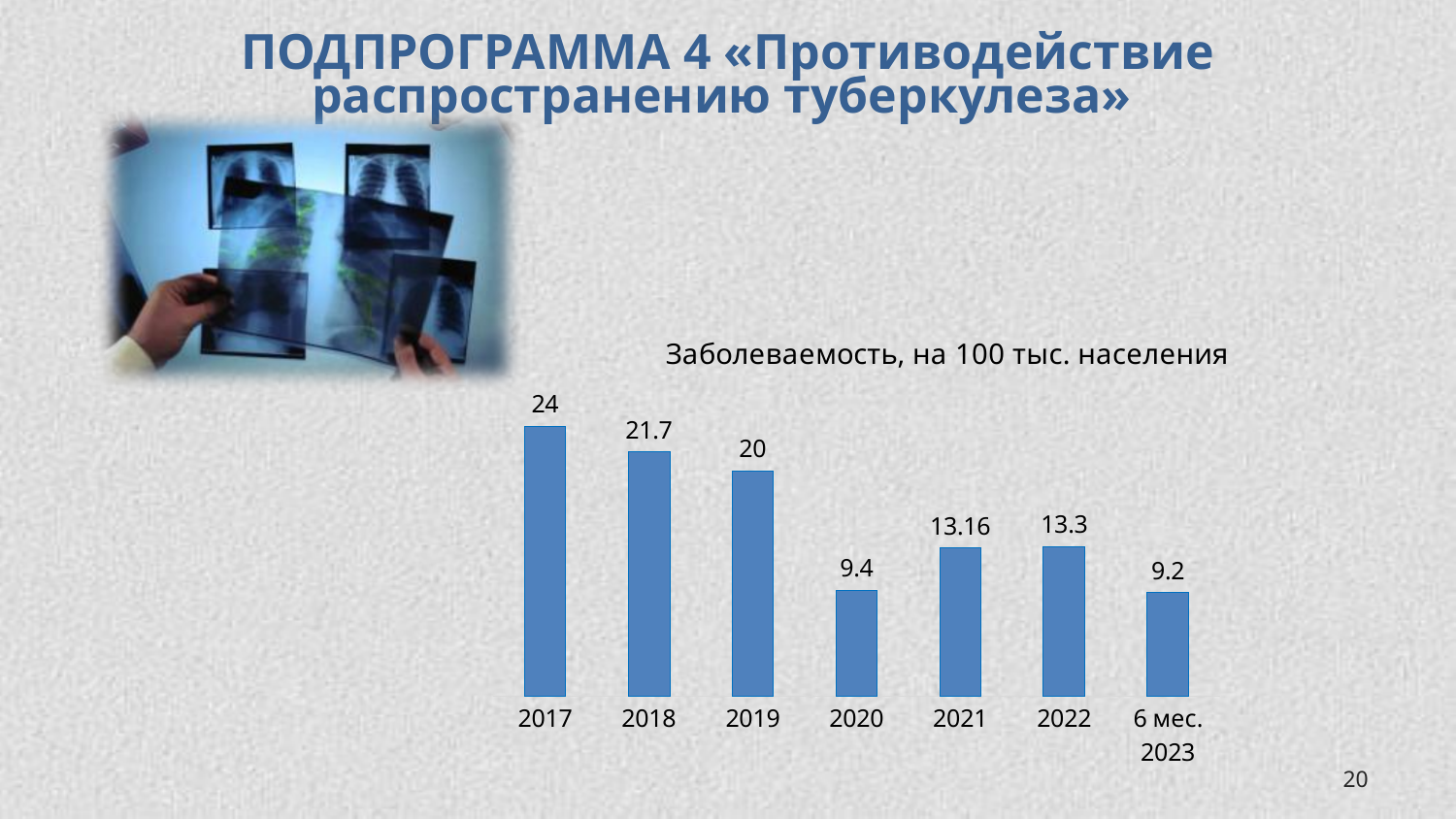
What is the title of the chart? Заболеваемость, на 100 тыс. населения Which category has the highest value? 2017 What is the difference between the values for 2017 and 2018? 2.3 Which is larger, the value for 2019 or the value for 2022? 2019 What is the value for 2017? 24 What is the value for 2020? 9.4 What is the value for 2021? 13.16 Which category has the lowest value? 6 мес. 2023 How many categories are shown on the x axis? 7 What is the difference between the values for 2019 and 2020? 10.6 What kind of chart is this? bar chart What is the value for 6 мес. 2023? 9.2